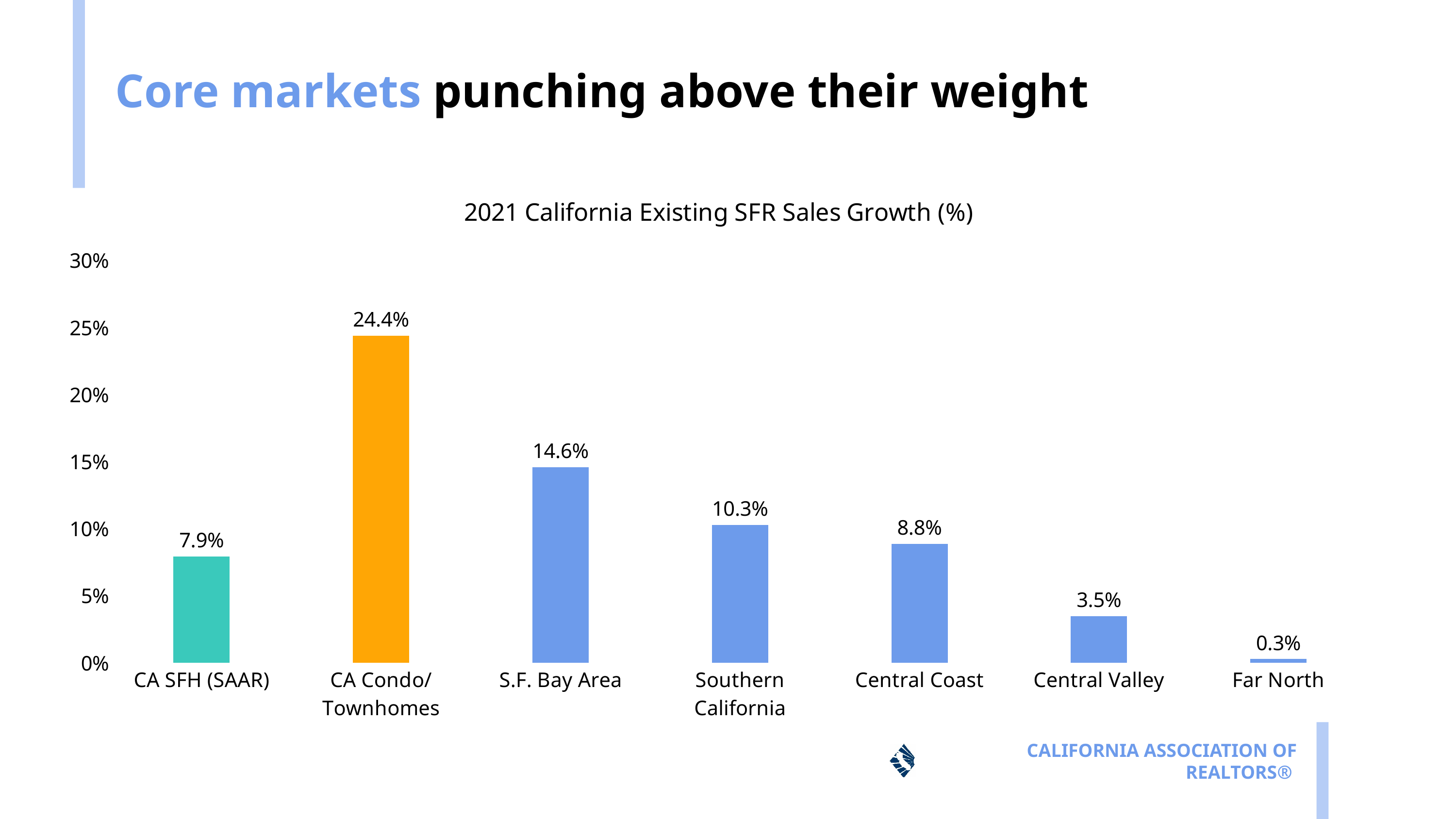
Is the value for CA SFH (SAAR) greater or less than 10%? less Which is larger, the value for Central Coast or the value for Central Valley? Central Coast How many categories are shown on the chart? 7 What is the value shown for CA Condo/Townhomes? 24.4% What is the title of the chart? 2021 California Existing SFR Sales Growth (%) Which category has the highest sales growth? CA Condo/Townhomes What is the sales growth value for Far North? 0.3% Which category has the lowest sales growth? Far North What kind of chart is shown on the slide? bar chart What is the 2021 existing SFR sales growth for S.F. Bay Area? 14.6% What is the difference between the values for S.F. Bay Area and Southern California? 4.3% What colour is the bar for CA Condo/Townhomes? orange